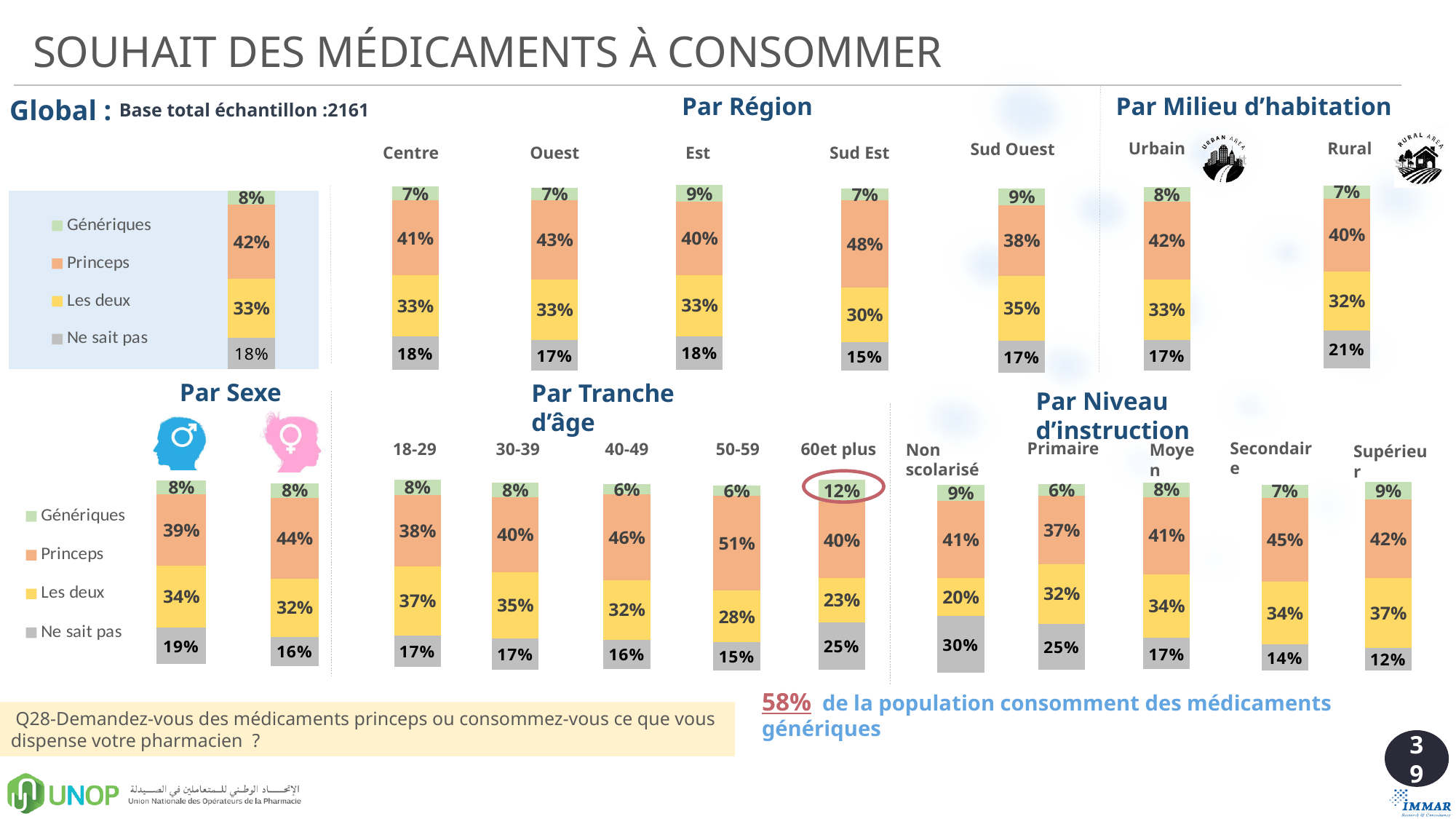
How many series does the legend of the Global chart list? 4 In the Global chart, what percentage is shown for Princeps? 42% In the Par Région chart, which region has the highest Princeps value? Sud Est In the Par Région chart, what is the Princeps value for Sud Est? 48% In the Par Région chart, which region has the lowest Ne sait pas value? Sud Est In the Par Niveau d'instruction chart, what is the Ne sait pas value for Non scolarisé? 30% In the Par Sexe chart, which sex has the larger Princeps value? Female (44%) How many categories are shown in the Par Niveau d'instruction chart? 5 In the Par Tranche d'âge chart, what is the Génériques value for 60et plus? 12% In the Par Tranche d'âge chart, which age group has the highest Princeps value? 50-59 In the Par Milieu d'habitation chart, what is the Ne sait pas value for Rural? 21% In the Par Milieu d'habitation chart, what is the difference between the Princeps values for Urbain and Rural? 2%